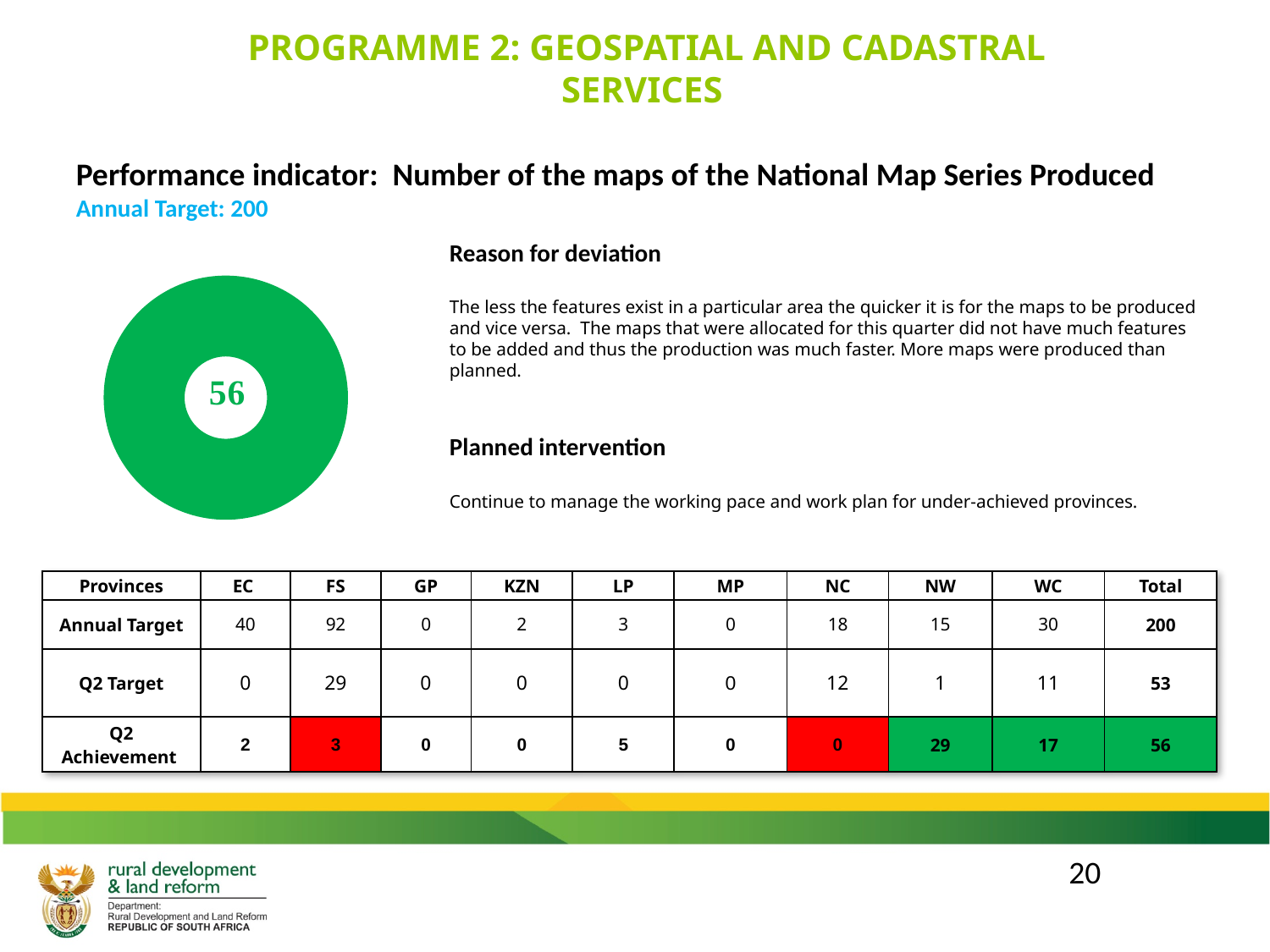
What kind of chart is shown on the left of the slide? doughnut chart Does the doughnut chart have a legend? No What colour is the ring of the doughnut chart? green Which row total in the table matches the value shown in the centre of the doughnut chart? Q2 Achievement How many slices are visible in the doughnut chart? 1 Is the value shown in the centre of the doughnut chart greater or less than 50? greater What value is printed in the centre of the doughnut chart? 56